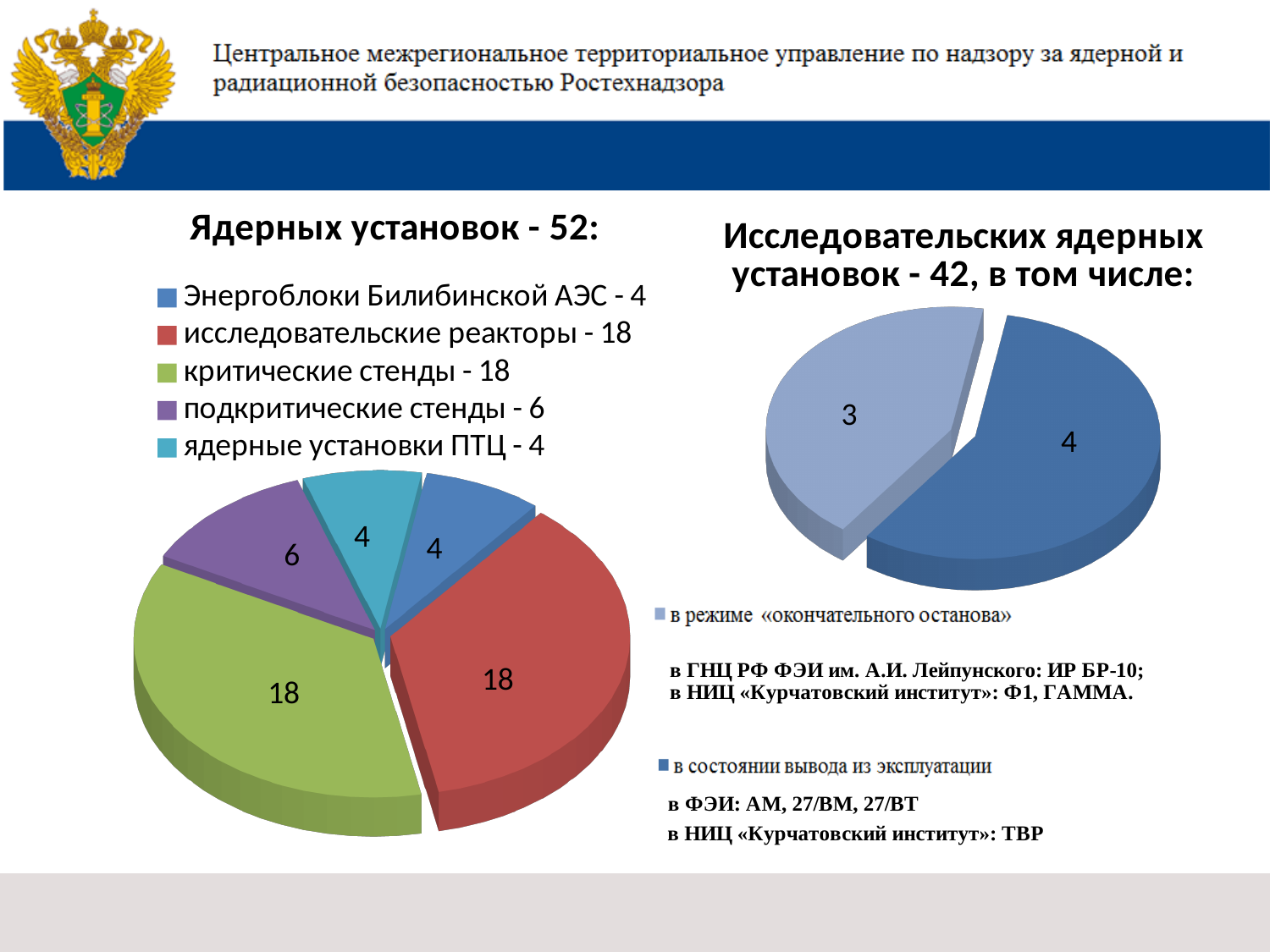
In the left chart "Ядерных установок - 52:", what is the difference between the value for "критические стенды" and the value for "подкритические стенды"? 12 In the right chart "Исследовательских ядерных установок - 42, в том числе:", what is the value for "в режиме «окончательного останова»"? 3 In the right chart "Исследовательских ядерных установок - 42, в том числе:", what is the value for "в состоянии вывода из эксплуатации"? 4 In the right chart "Исследовательских ядерных установок - 42, в том числе:", which category has the highest value? в состоянии вывода из эксплуатации In the left chart "Ядерных установок - 52:", what is the value for "подкритические стенды"? 6 In the left chart "Ядерных установок - 52:", what share of the total do "исследовательские реакторы" represent? 18 of 52 In the left chart "Ядерных установок - 52:", which is larger: "исследовательские реакторы" or "ядерные установки ПТЦ"? исследовательские реакторы In the left chart "Ядерных установок - 52:", what is the value for "Энергоблоки Билибинской АЭС"? 4 What kind of chart is the left chart titled "Ядерных установок - 52:"? pie chart In the left chart "Ядерных установок - 52:", what colour is the slice for "критические стенды"? green In the right chart "Исследовательских ядерных установок - 42, в том числе:", how many slices does the pie have? 2 In the left chart "Ядерных установок - 52:", how many categories does the legend list? 5